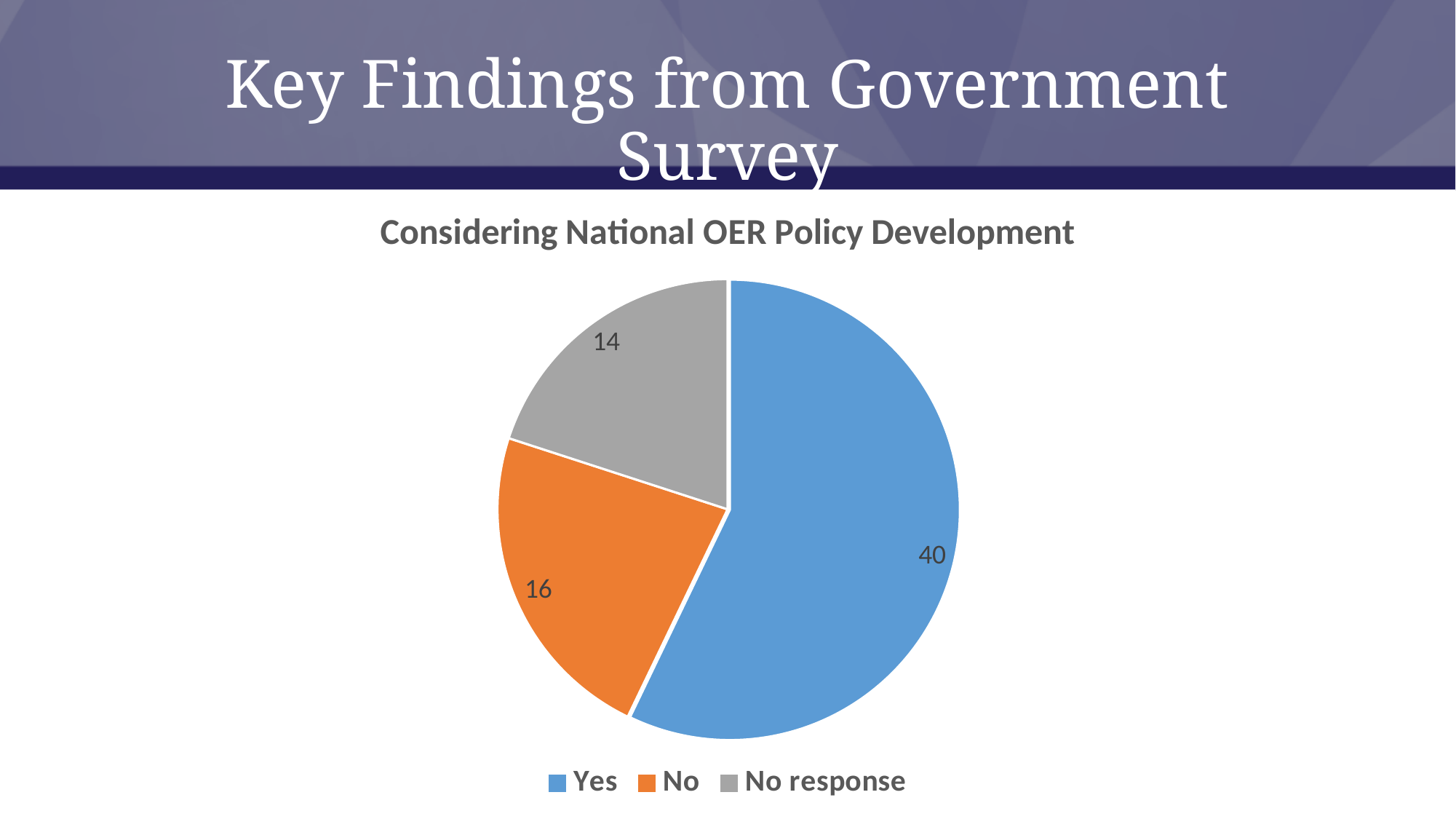
Which category has the largest slice? Yes What is the title of the chart? Considering National OER Policy Development What is the difference between the values for No and No response? 2 What type of chart is shown on the slide? pie chart Which is larger, the value for Yes or the value for No response? Yes How many categories does the pie chart have? 3 What is the value for Yes? 40 Which category has the smallest slice? No response What is the value for No response? 14 What is the difference between the values for Yes and No? 24 What is the value for No? 16 What share of the pie does the No slice represent? 16 out of 70